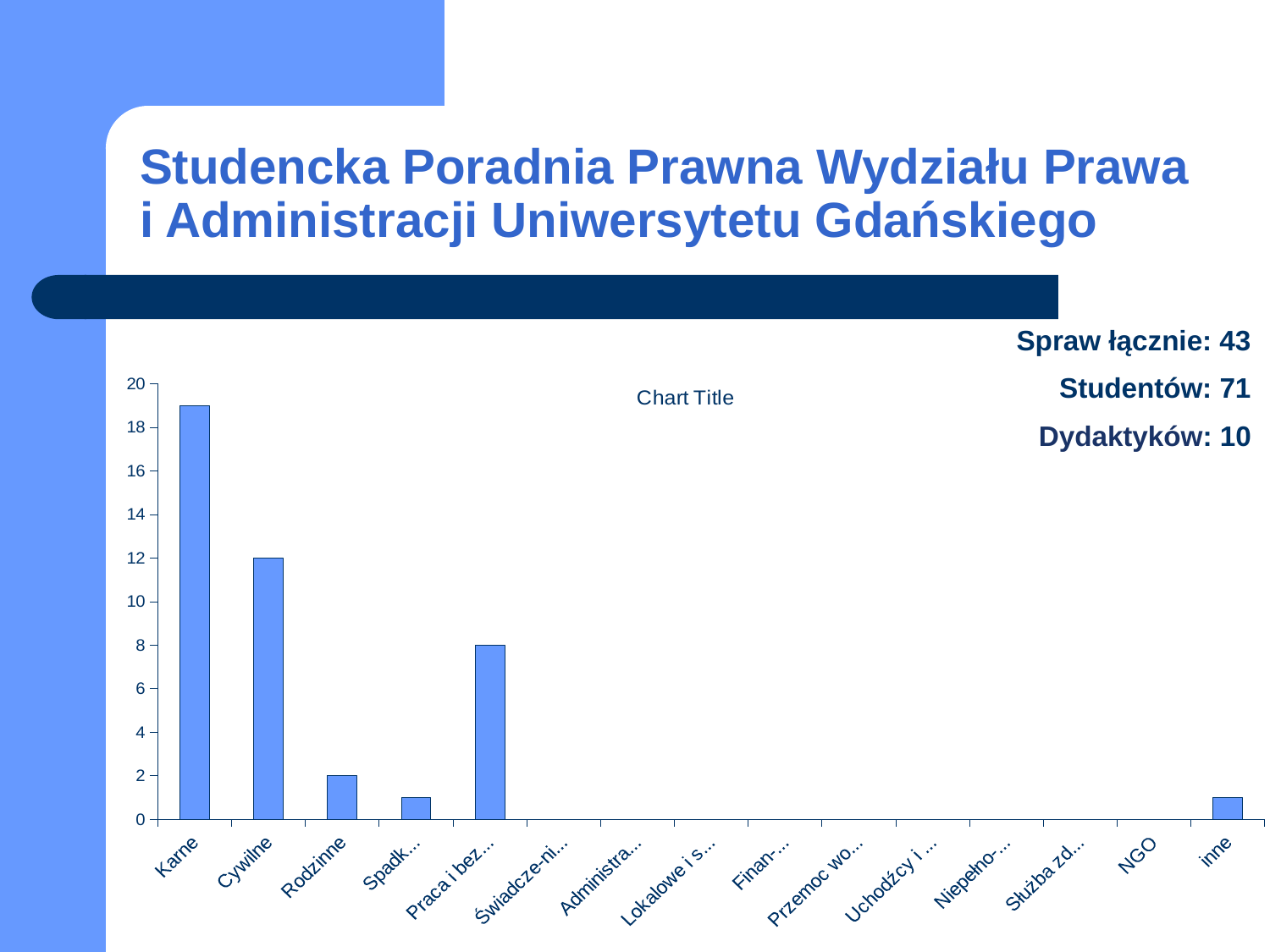
What is the value for Praca i bez...? 8 Is the value for Karne greater or less than 18? greater What is the value for Rodzinne? 2 Which category has the highest value? Karne Which is larger, the value for Praca i bez... or the value for Rodzinne? Praca i bez... What is the title of the chart? Chart Title Is the value for Spadk... greater or less than 2? less What type of chart is shown on the slide? bar chart What is the value for Cywilne? 12 How many categories are shown on the x axis? 15 What is the difference between the values for Cywilne and Praca i bez...? 4 Which is larger, the value for Karne or the value for Cywilne? Karne